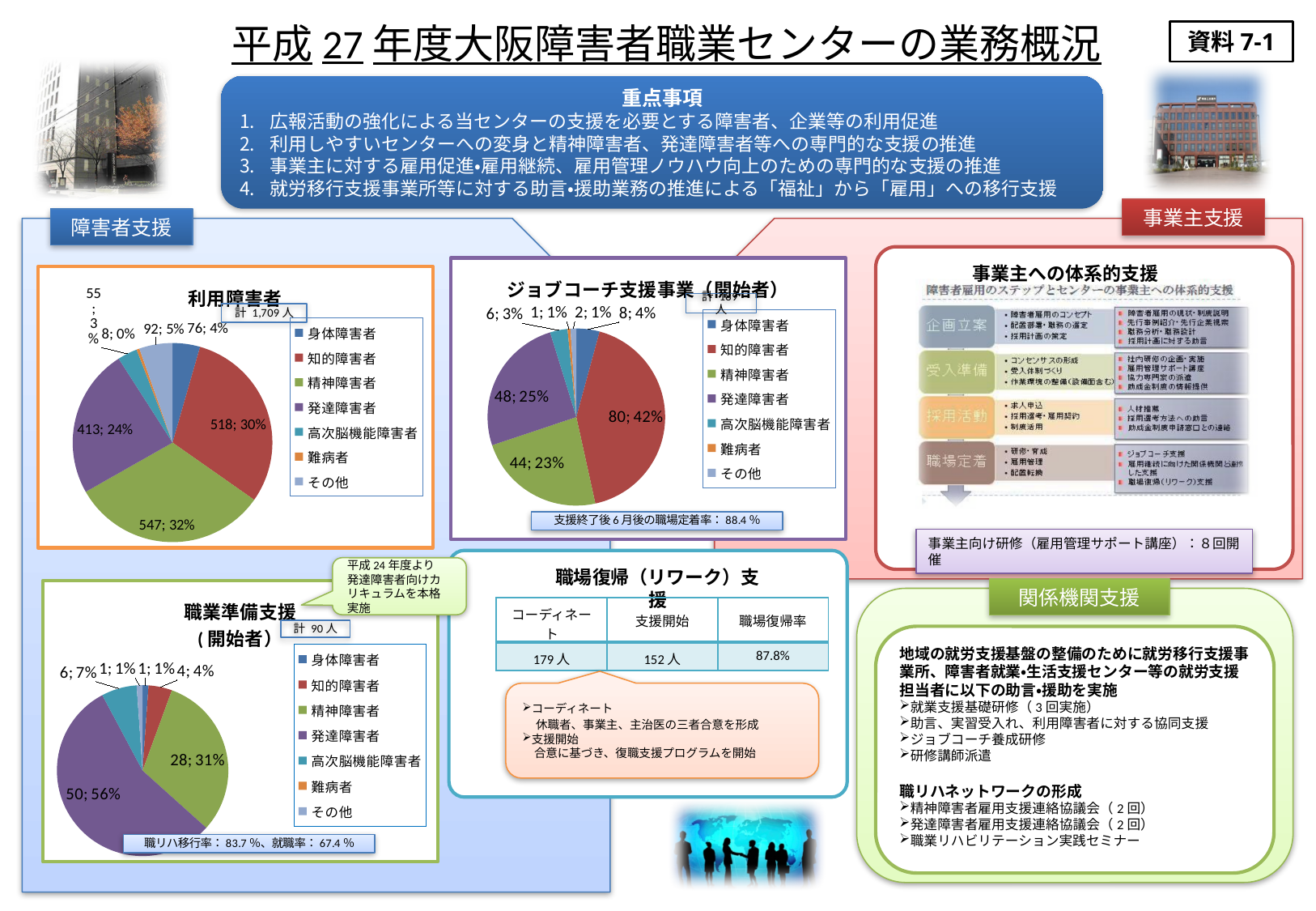
In the 利用障害者 pie chart, what is the value shown for 精神障害者? 547; 32% What type of chart is used for 職業準備支援（開始者）? Pie chart In the ジョブコーチ支援事業（開始者） pie chart, which is larger, 精神障害者 or 発達障害者? 発達障害者 In the 職業準備支援（開始者） pie chart, what is the total number of people shown (計)? 90人 In the ジョブコーチ支援事業（開始者） pie chart, what is the value shown for 知的障害者? 80; 42% In the 利用障害者 pie chart, what is the value shown for 発達障害者? 413; 24% In the 利用障害者 pie chart, what is the total number of people shown (計)? 1,709人 How many categories does the legend of the 利用障害者 pie chart list? 7 In the 利用障害者 pie chart, which category has the largest slice? 精神障害者 In the 職業準備支援（開始者） pie chart, what is the value shown for 発達障害者? 50; 56% In the ジョブコーチ支援事業（開始者） pie chart, what share of the pie does 精神障害者 hold? 23% In the 利用障害者 pie chart, what is the difference between the counts for 知的障害者 and 発達障害者? 105